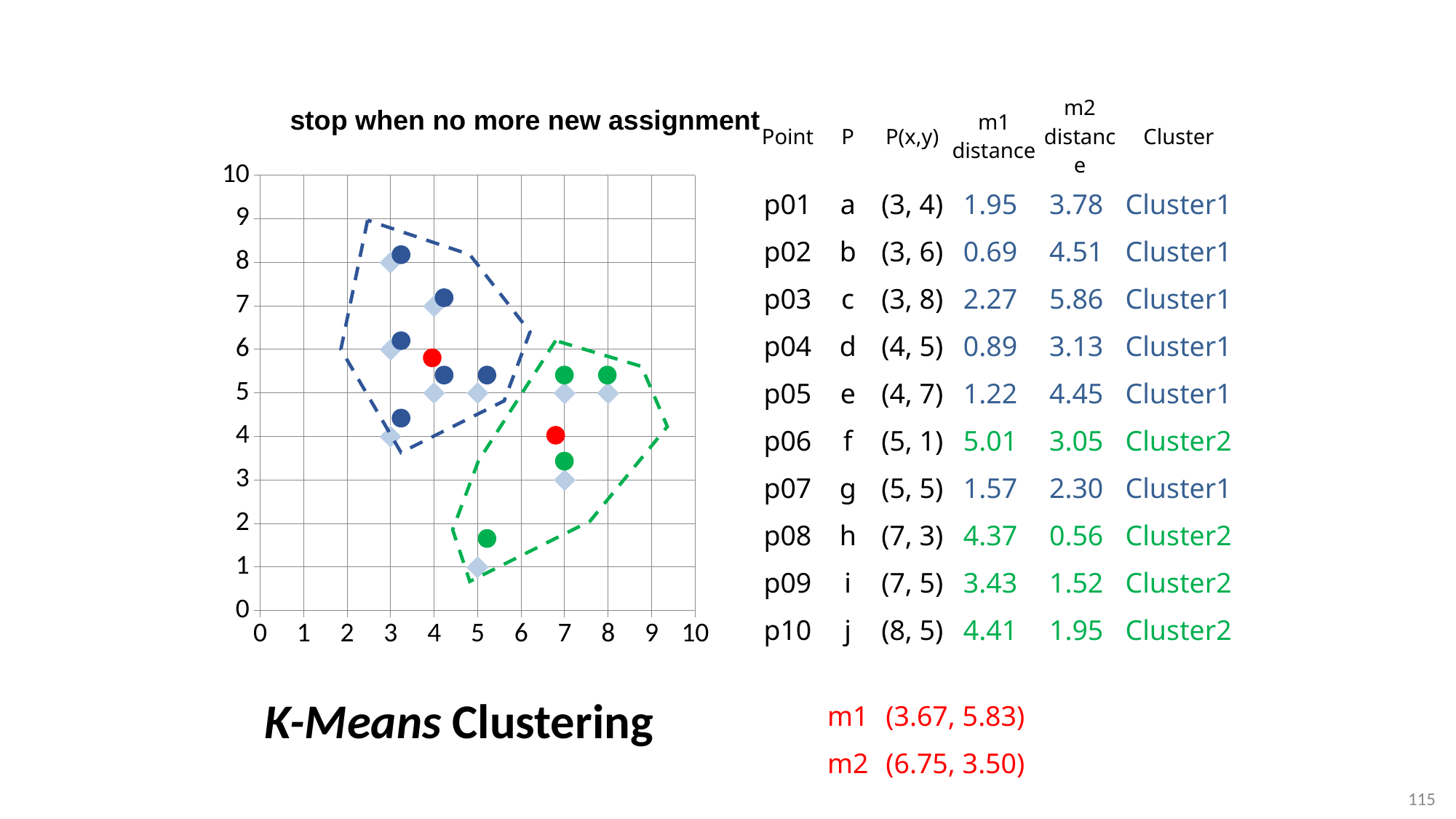
What kind of chart is shown on the slide? scatter chart What is the title printed above the chart? stop when no more new assignment What are the coordinates of centroid m1? (3.67, 5.83) What is the highest value shown on the chart's x axis? 10 Which point has the largest m1 distance? f (p06) How many points are assigned to Cluster2? 4 Which cluster is point g (p07) assigned to? Cluster1 Which point has the smallest m2 distance? h (p08) How many points are listed in the table next to the chart? 10 What is the difference between the m2 distance and the m1 distance for point a (p01)? 1.83 What are the coordinates P(x,y) of point a (p01)? (3, 4) What is the m2 distance for point h (p08)? 0.56